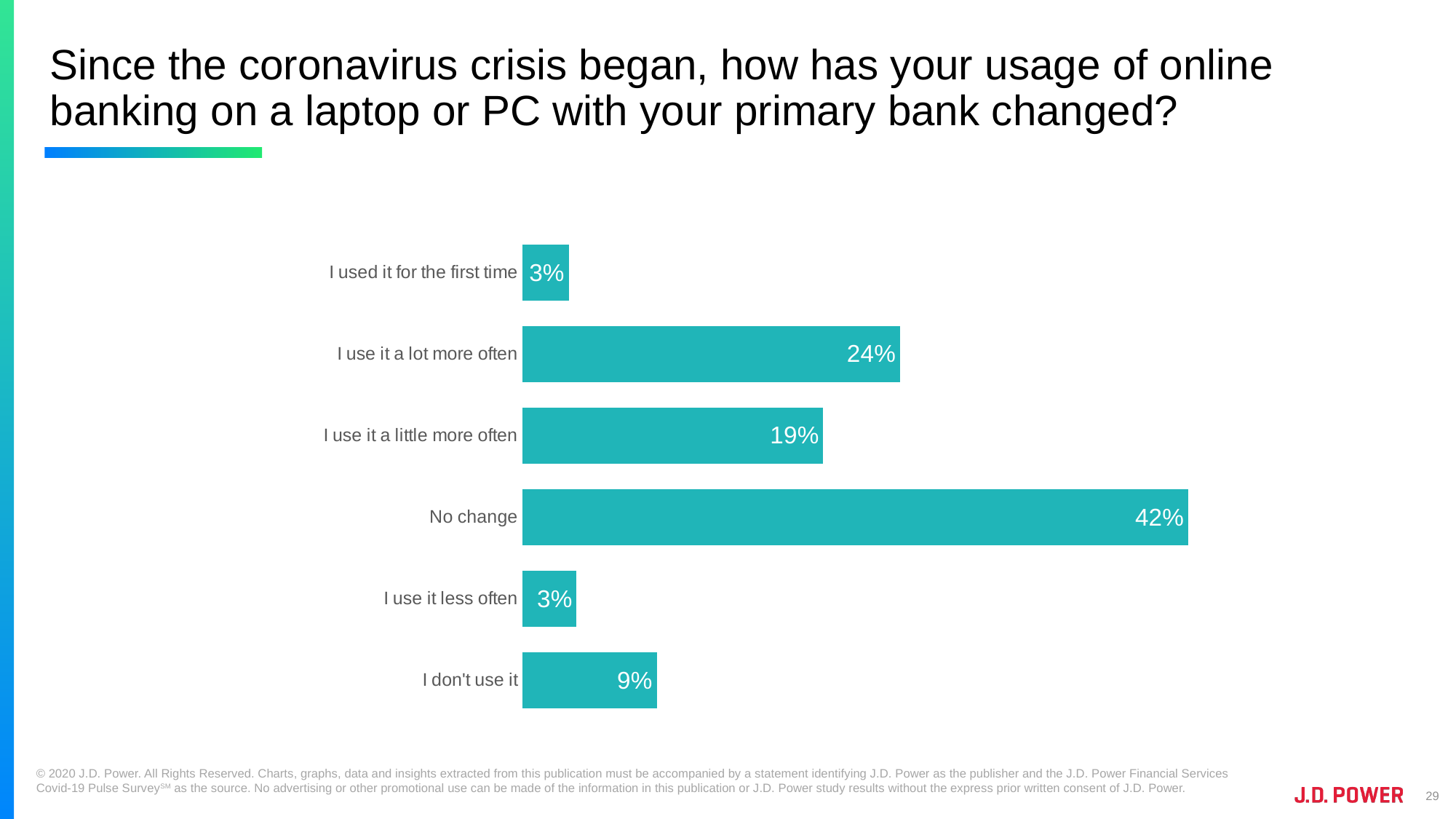
What is the difference between "I use it a lot more often" and "I use it a little more often"? 5% What is the value for "I used it for the first time"? 3% What percentage of respondents said "No change"? 42% What colour are the bars in the chart? Teal What percentage of respondents said "I don't use it"? 9% What is the value for "I use it a lot more often"? 24% What kind of chart is shown on the slide? Bar chart Which category has the highest value? No change Which is larger: "I don't use it" or "I use it less often"? I don't use it How many categories are shown in the chart? 6 What is the difference between "No change" and "I use it a lot more often"? 18% What is the value for "I use it a little more often"? 19%